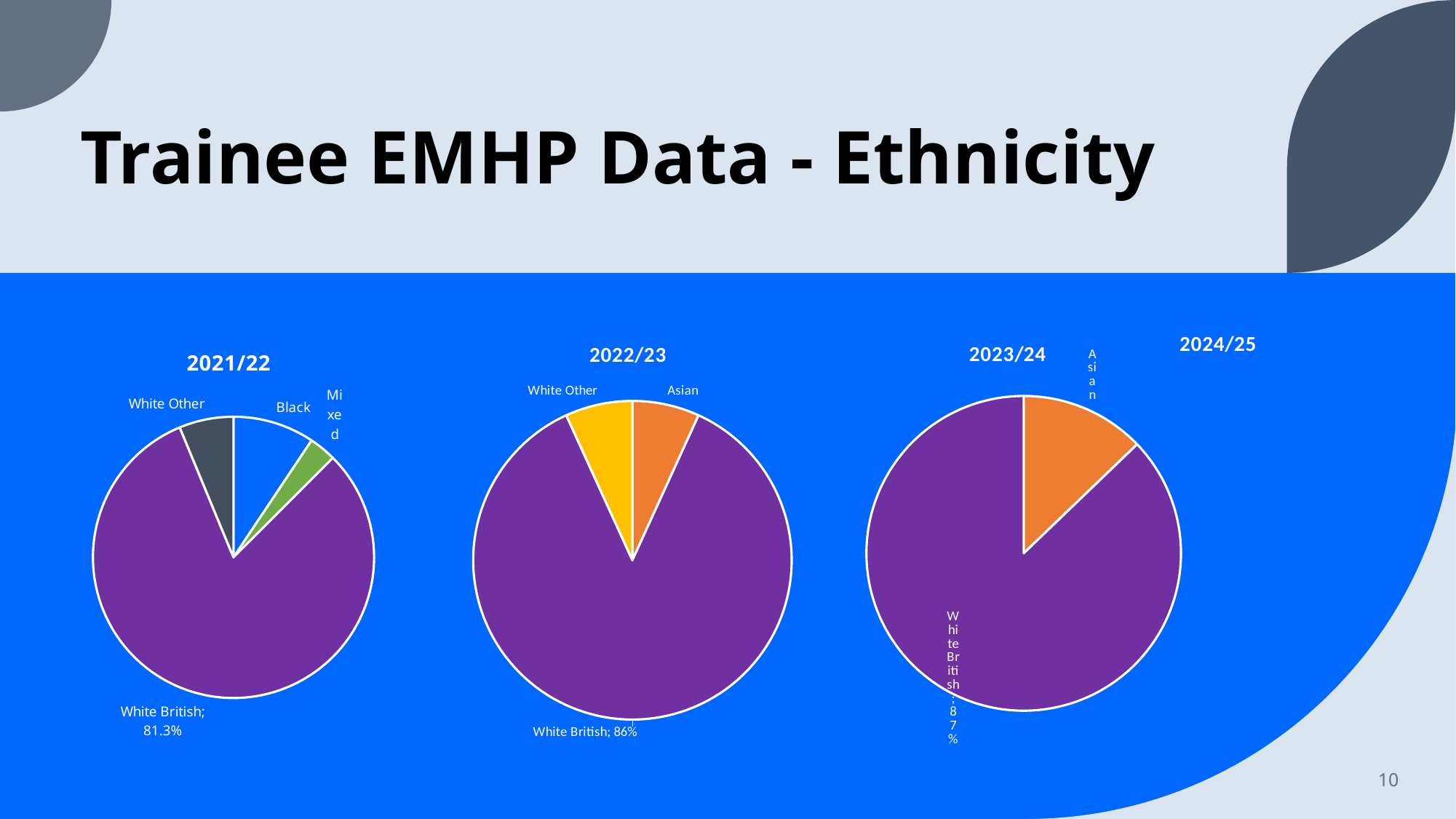
In the 2022/23 pie chart, what share is shown for White British? 86% How many ethnicity categories are labelled in the 2021/22 pie chart? 4 How many ethnicity categories are labelled in the 2023/24 pie chart? 2 What kind of chart is used for the 2022/23 data? Pie chart In the 2021/22 pie chart, what share is shown for White British? 81.3% In the 2022/23 pie chart, which category is shown in yellow? White Other In the 2021/22 pie chart, which category has the largest slice? White British Is the White British share larger in the 2022/23 chart or the 2023/24 chart? 2023/24 How many ethnicity categories are labelled in the 2022/23 pie chart? 3 By how many percentage points does the White British share in 2023/24 exceed that in 2022/23? 1% In the 2021/22 pie chart, which slice is larger: White Other or Mixed? White Other In the 2023/24 pie chart, what share is shown for White British? 87%